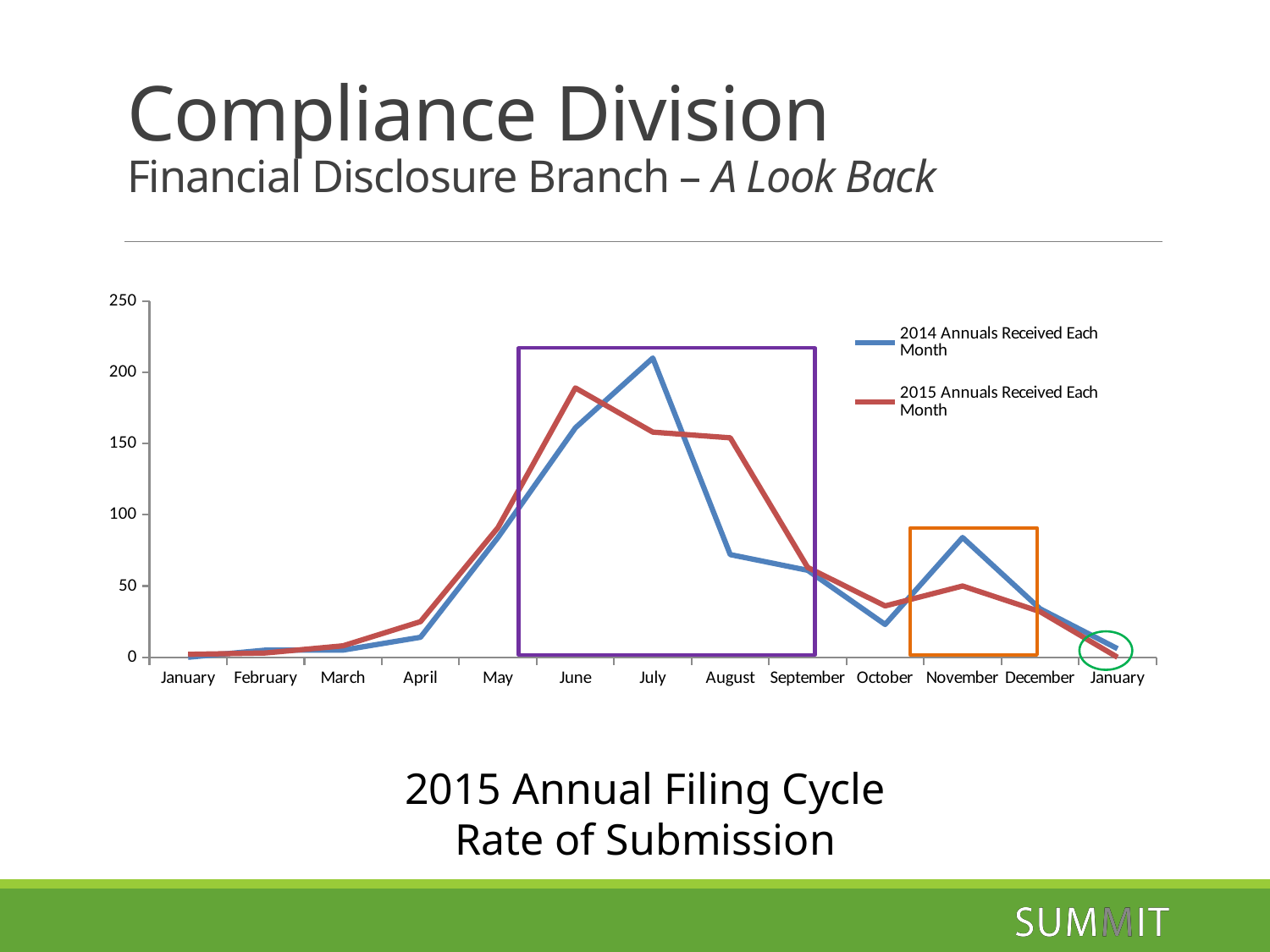
Is the value for 2015 Annuals Received Each Month in August greater or less than 100? greater In which month does the 2015 Annuals Received Each Month series reach its highest value? June In which month does the 2014 Annuals Received Each Month series reach its highest value? July Do the values for 2014 Annuals Received Each Month rise or fall from July to August? fall Is the value for 2014 Annuals Received Each Month in July greater or less than 200? greater How many series does the legend list? 2 Which series has the larger value in November, 2014 Annuals Received Each Month or 2015 Annuals Received Each Month? 2014 Annuals Received Each Month Which series has the larger value in August, 2014 Annuals Received Each Month or 2015 Annuals Received Each Month? 2015 Annuals Received Each Month What kind of chart is shown on the slide? line chart How many points are plotted along the x axis for each series? 13 What colour is the line for 2015 Annuals Received Each Month? red Is the value for 2015 Annuals Received Each Month in June greater or less than 200? less